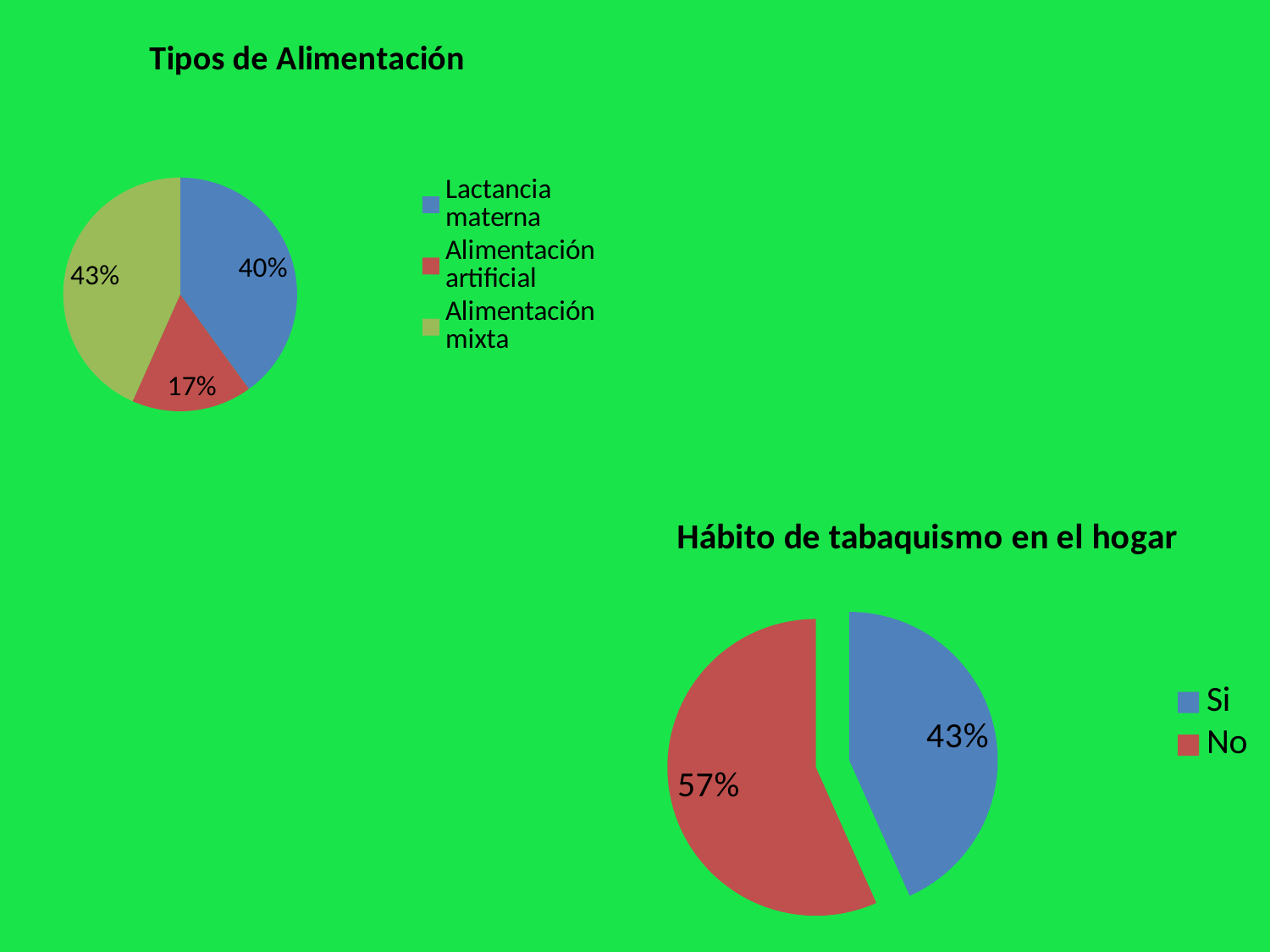
In the 'Hábito de tabaquismo en el hogar' chart, what share does 'Si' have? 43% In the 'Tipos de Alimentación' chart, what is the difference between the shares of Alimentación mixta and Alimentación artificial? 26% In the 'Hábito de tabaquismo en el hogar' chart, which is larger, 'Si' or 'No'? No What type of chart is 'Hábito de tabaquismo en el hogar'? Pie chart In the 'Tipos de Alimentación' chart, how many categories are shown? 3 In the 'Tipos de Alimentación' chart, which category has the smallest share? Alimentación artificial In the 'Tipos de Alimentación' chart, what share does Lactancia materna have? 40% In the 'Hábito de tabaquismo en el hogar' chart, what is the difference between the 'No' and 'Si' shares? 14% In the 'Tipos de Alimentación' chart, what share does Alimentación artificial have? 17% In the 'Hábito de tabaquismo en el hogar' chart, what share does 'No' have? 57% In the 'Tipos de Alimentación' chart, what share does Alimentación mixta have? 43% In the 'Tipos de Alimentación' chart, which category has the largest share? Alimentación mixta